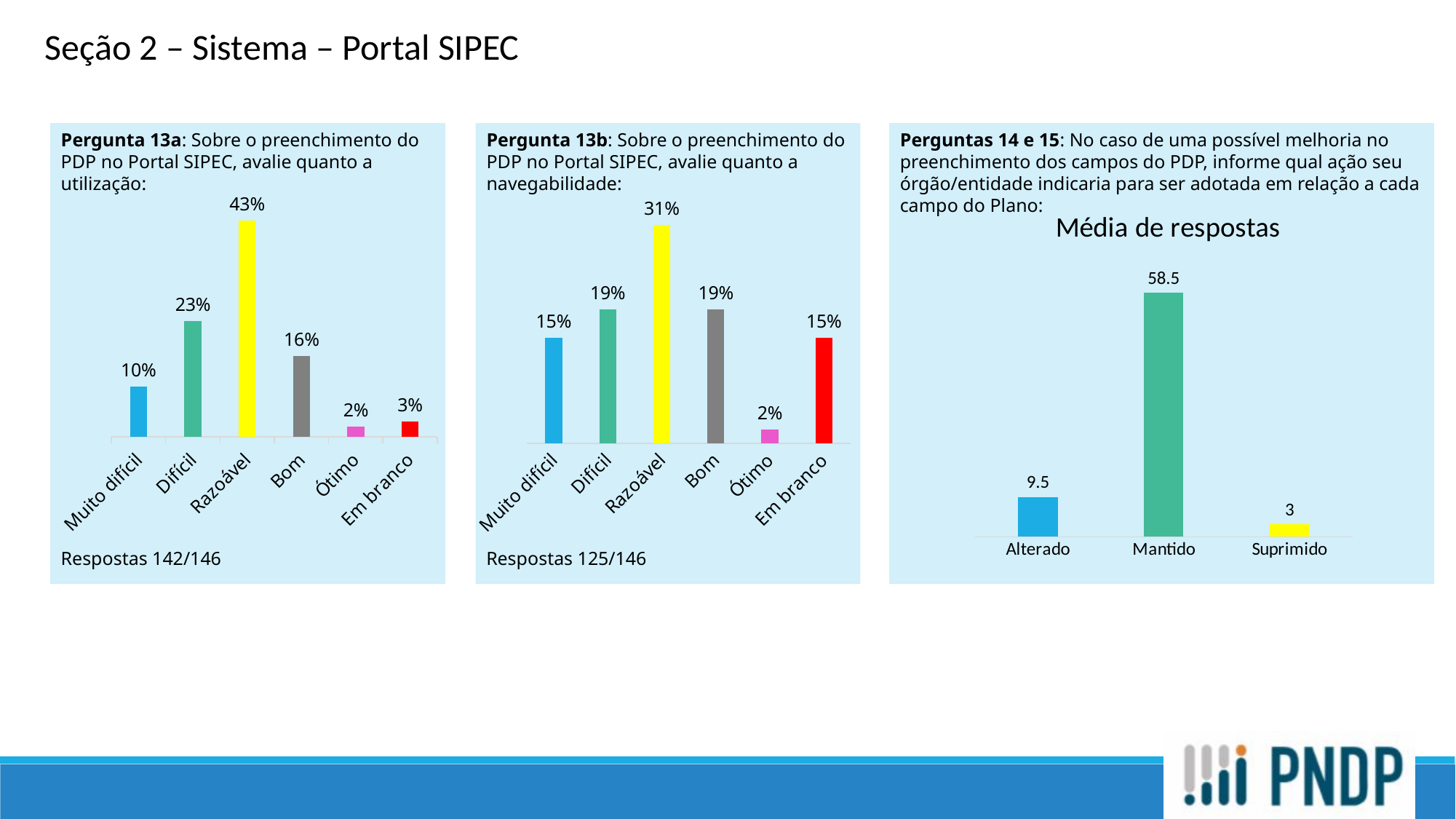
In the Pergunta 13b chart (middle), which is larger, Muito difícil or Difícil? Difícil In the Pergunta 13a chart (left), how many categories are shown? 6 In the Pergunta 13a chart (left), which category has the lowest value? Ótimo In the Média de respostas chart (right), what is the difference between Mantido and Alterado? 49 In the Média de respostas chart (right), which category has the lowest value? Suprimido What kind of chart is the Média de respostas chart (right)? Bar chart In the Pergunta 13b chart (middle), which category has the highest value? Razoável In the Pergunta 13b chart (middle), what is the difference between Razoável and Bom? 12% In the Pergunta 13a chart (left), what is the value for Razoável? 43% In the Pergunta 13b chart (middle), what is the value for Em branco? 15% In the Pergunta 13a chart (left), what is the difference between Difícil and Bom? 7% In the Média de respostas chart (right), what is the value for Mantido? 58.5